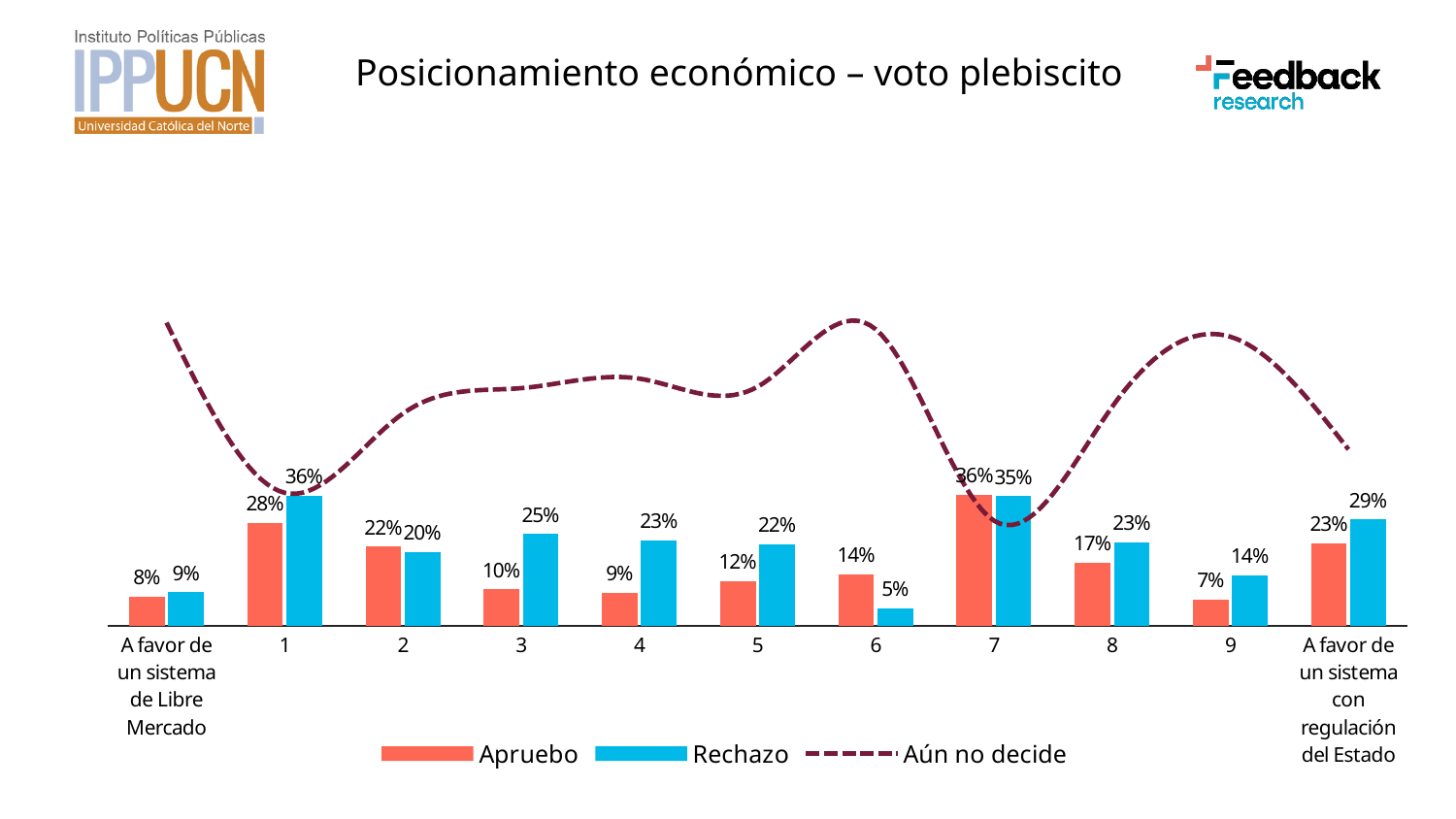
What is the Apruebo value for category 1? 28% How many categories are shown on the x axis? 11 How many series does the legend list? 3 What kind of chart is used for the Apruebo and Rechazo series? Bar chart What is the difference between the Rechazo and Apruebo values for category 4? 14% For category 6, which is larger, Apruebo or Rechazo? Apruebo Which series is drawn as a dashed line? Aún no decide What is the Rechazo value for 'A favor de un sistema con regulación del Estado'? 29% What is the Rechazo value for category 3? 25% Which category has the lowest Rechazo value? 6 What is the Apruebo value for 'A favor de un sistema de Libre Mercado'? 8% Which category has the highest Apruebo value? 7